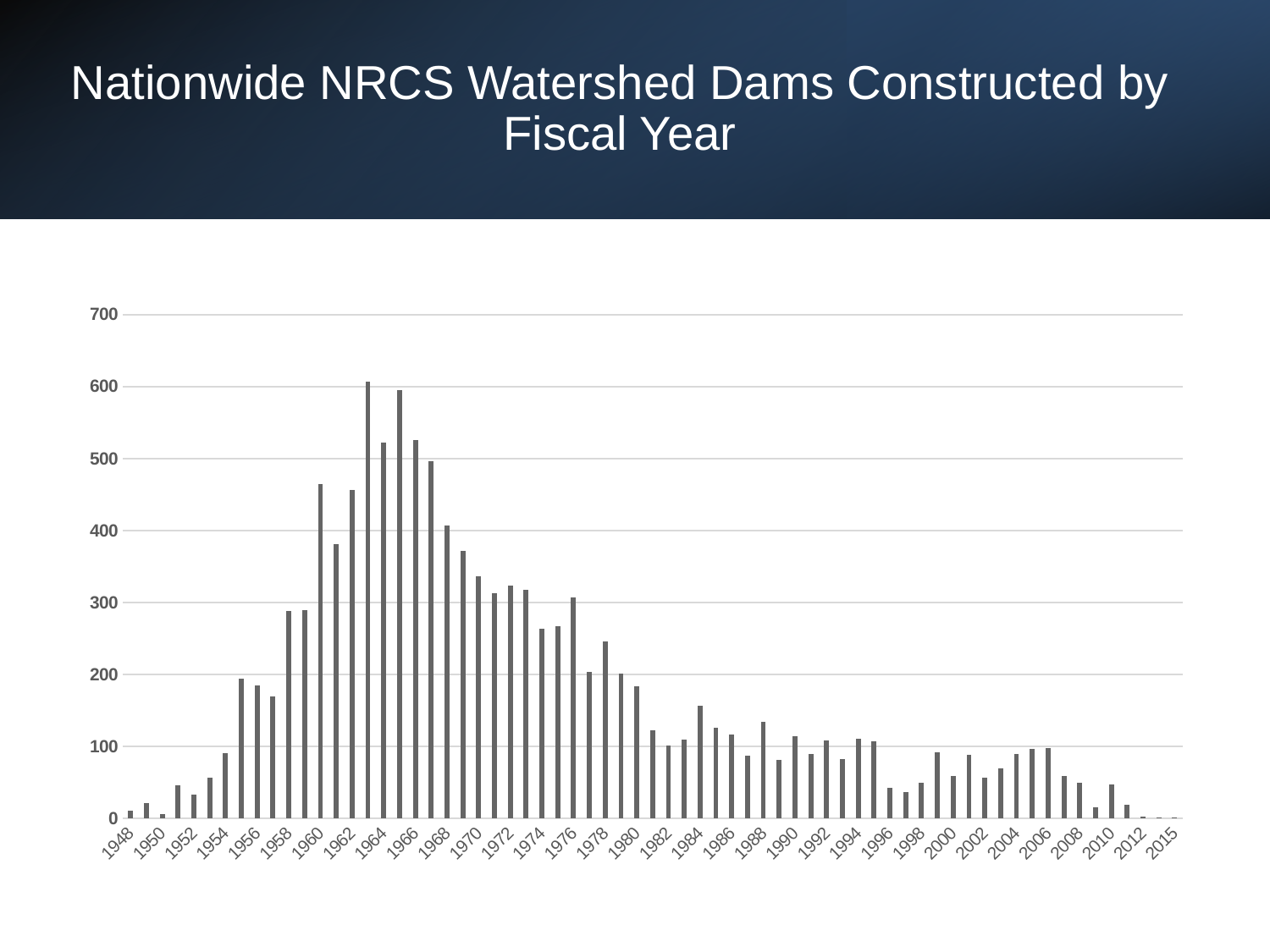
Is the value for 1996 greater or less than 100? less Is the value for 1966 greater or less than 500? greater Is the value for 1960 greater or less than 400? greater Which year has the larger value, 1960 or 1980? 1960 Do the values generally rise or fall from 1966 to 1980? fall Which year has the larger value, 1950 or 1970? 1970 What kind of chart is shown on the slide? bar chart What is the title of the chart on the slide? Nationwide NRCS Watershed Dams Constructed by Fiscal Year